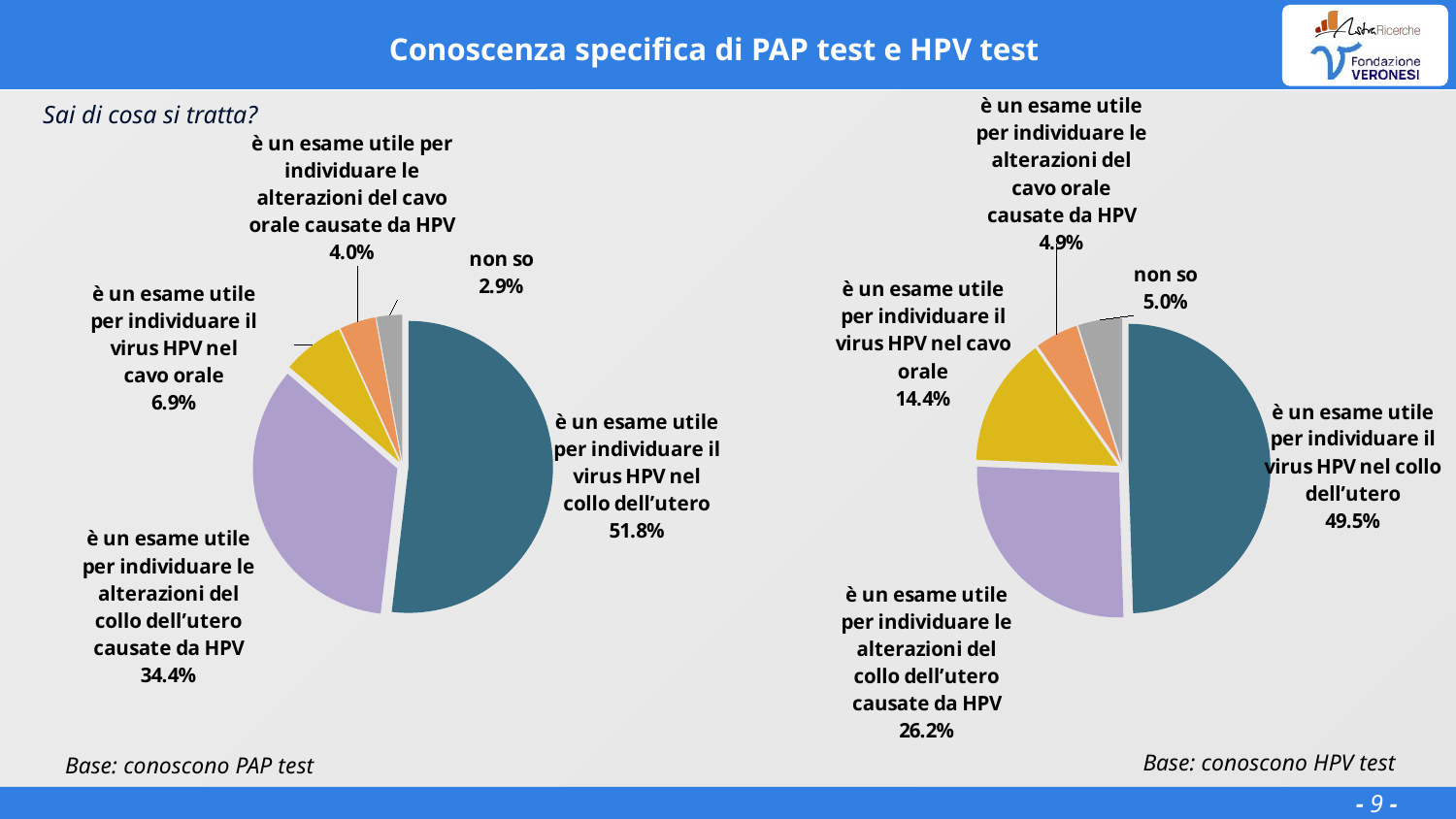
Which is larger in the right pie chart (Base: conoscono HPV test): the share for 'virus HPV nel cavo orale' or the share for 'non so'? virus HPV nel cavo orale In the right pie chart (Base: conoscono HPV test), what share of respondents said it is an exam useful to detect alterations of the cervix caused by HPV? 26.2% In the right pie chart (Base: conoscono HPV test), what percentage said it is an exam useful to detect the HPV virus in the oral cavity (cavo orale)? 14.4% What is the title of the slide containing the two pie charts? Conoscenza specifica di PAP test e HPV test What kind of chart is shown on the left side of the slide (Base: conoscono PAP test)? Pie chart In the left pie chart (Base: conoscono PAP test), what percentage answered 'non so'? 2.9% In the left pie chart (Base: conoscono PAP test), which answer has the largest share? è un esame utile per individuare il virus HPV nel collo dell'utero In the left pie chart (Base: conoscono PAP test), what share of respondents said it is an exam useful to detect the HPV virus in the cervix (collo dell'utero)? 51.8% In the left pie chart (Base: conoscono PAP test), which answer has the smallest share? non so How many slices does the left pie chart (Base: conoscono PAP test) have? 5 In the left pie chart (Base: conoscono PAP test), what is the difference between the share for 'virus HPV nel collo dell'utero' and the share for 'alterazioni del collo dell'utero causate da HPV'? 17.4% In the right pie chart (Base: conoscono HPV test), which answer has the largest share? è un esame utile per individuare il virus HPV nel collo dell'utero